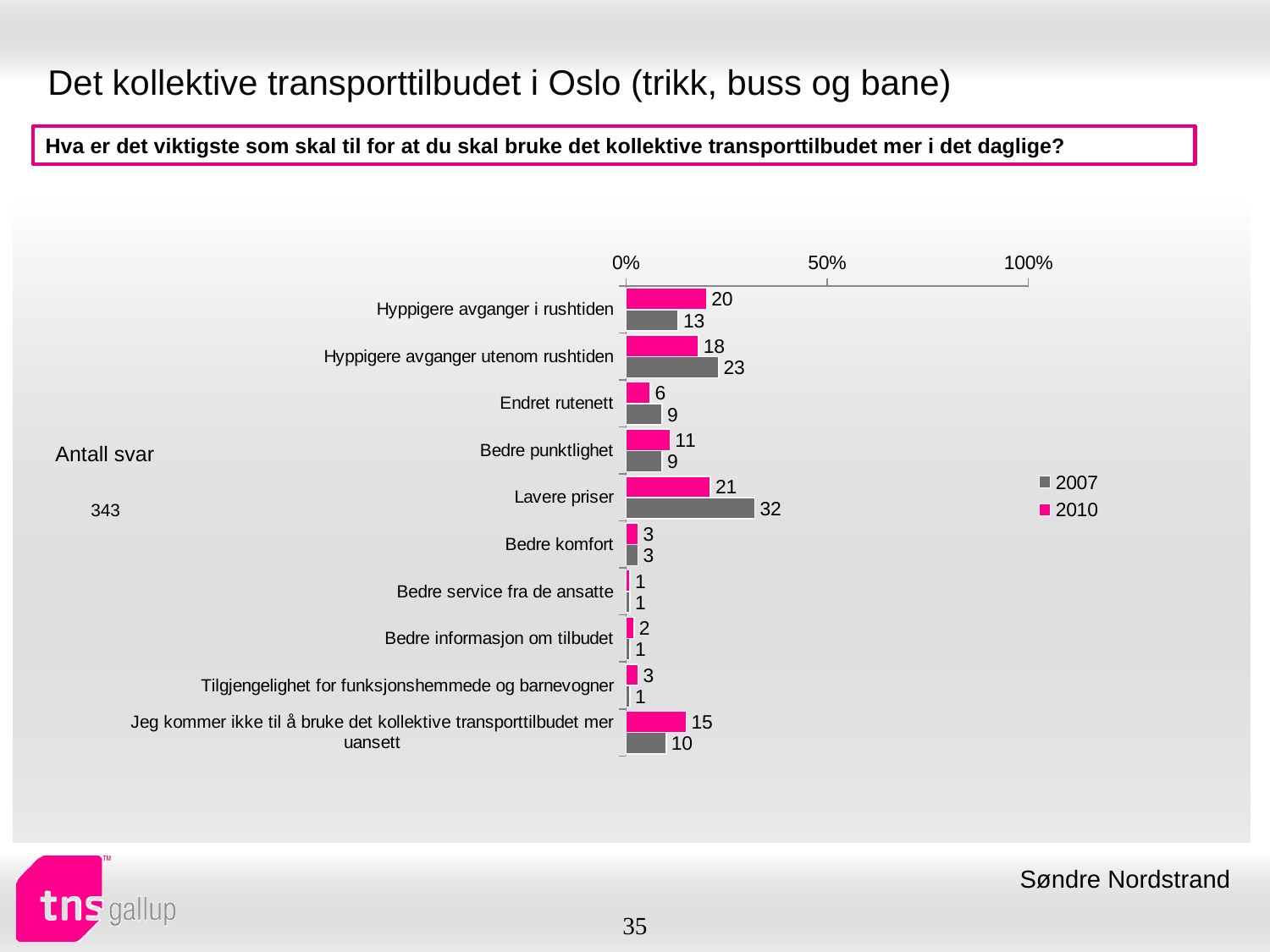
What is the 2010 value for "Hyppigere avganger i rushtiden"? 20 Is the 2007 value for "Lavere priser" greater or less than 50%? less Which colour represents the 2010 series in the chart? pink What is the 2007 value for "Lavere priser"? 32 Which category has the highest 2007 value? Lavere priser How many series does the legend list? 2 How many categories are shown in the chart? 10 What is the 2007 value for "Hyppigere avganger utenom rushtiden"? 23 Which category has the highest 2010 value? Lavere priser Which is larger for "Hyppigere avganger i rushtiden": the 2007 value or the 2010 value? 2010 What is the difference between the 2007 and 2010 values for "Lavere priser"? 11 What kind of chart is shown on the slide? bar chart